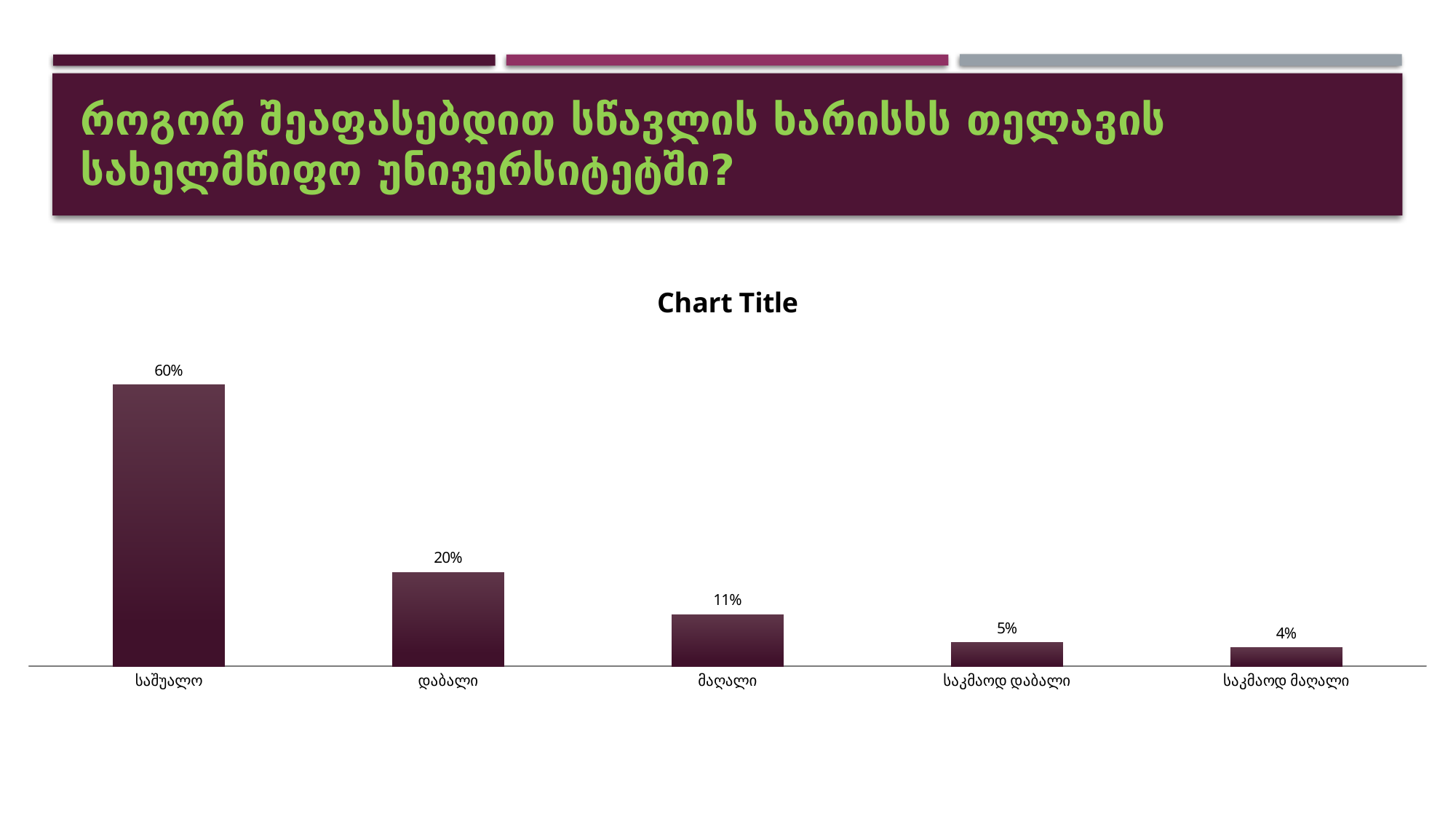
Which is larger, the value for დაბალი or the value for მაღალი? დაბალი What is the value for საკმაოდ მაღალი? 4% Which category has the lowest value? საკმაოდ მაღალი Which category has the highest value? საშუალო What is the value for საკმაოდ დაბალი? 5% What is the title printed above the chart? Chart Title How many categories are shown on the x axis? 5 What is the difference between the values for საშუალო and დაბალი? 40% What is the value for საშუალო? 60% What is the value for დაბალი? 20% What kind of chart is shown on the slide? bar chart What is the value for მაღალი? 11%